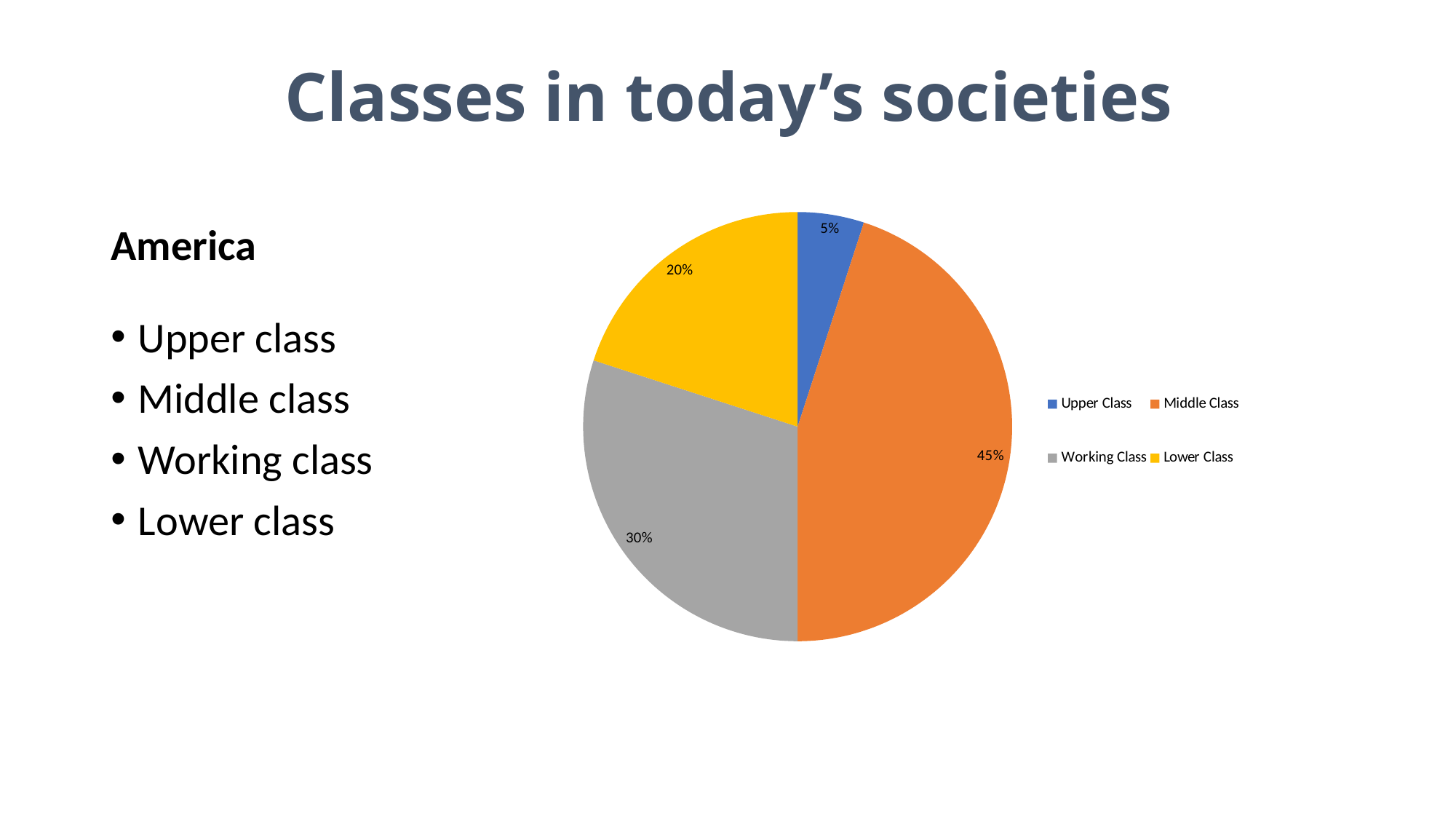
How many entries does the legend list? 4 Which class has the largest slice of the pie? Middle Class How many slices does the pie chart have? 4 Which is larger, the Working Class slice or the Lower Class slice? Working Class Which class has the smallest slice of the pie? Upper Class What is the difference in percentage points between Middle Class and Working Class? 15 What percentage of the pie is Middle Class? 45% What percentage of the pie is Lower Class? 20% What percentage of the pie is Upper Class? 5% What kind of chart is shown on the slide? pie chart What colour is the Lower Class slice? yellow What percentage of the pie is Working Class? 30%